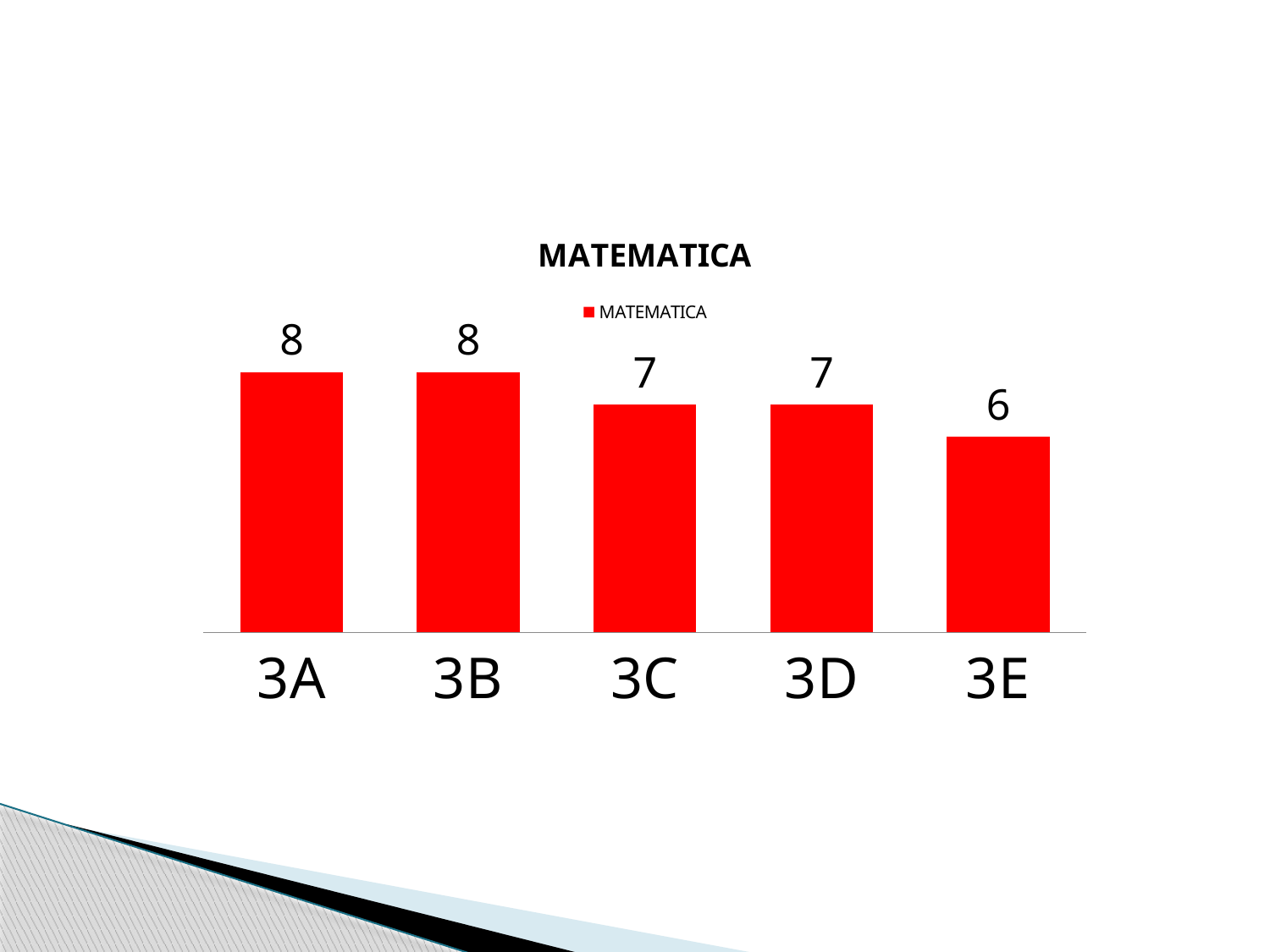
Which is larger, the value for 3B or the value for 3D? 3B What is the value for 3C? 7 What is the value for 3E? 6 What is the difference between the values for 3B and 3C? 1 Do the values rise or fall from 3A to 3E? fall What kind of chart is shown? bar chart Which category has the lowest value? 3E What is the value for 3A? 8 How many categories are shown on the x axis? 5 How many series does the legend list? 1 What is the value for 3D? 7 What is the difference between the values for 3A and 3E? 2